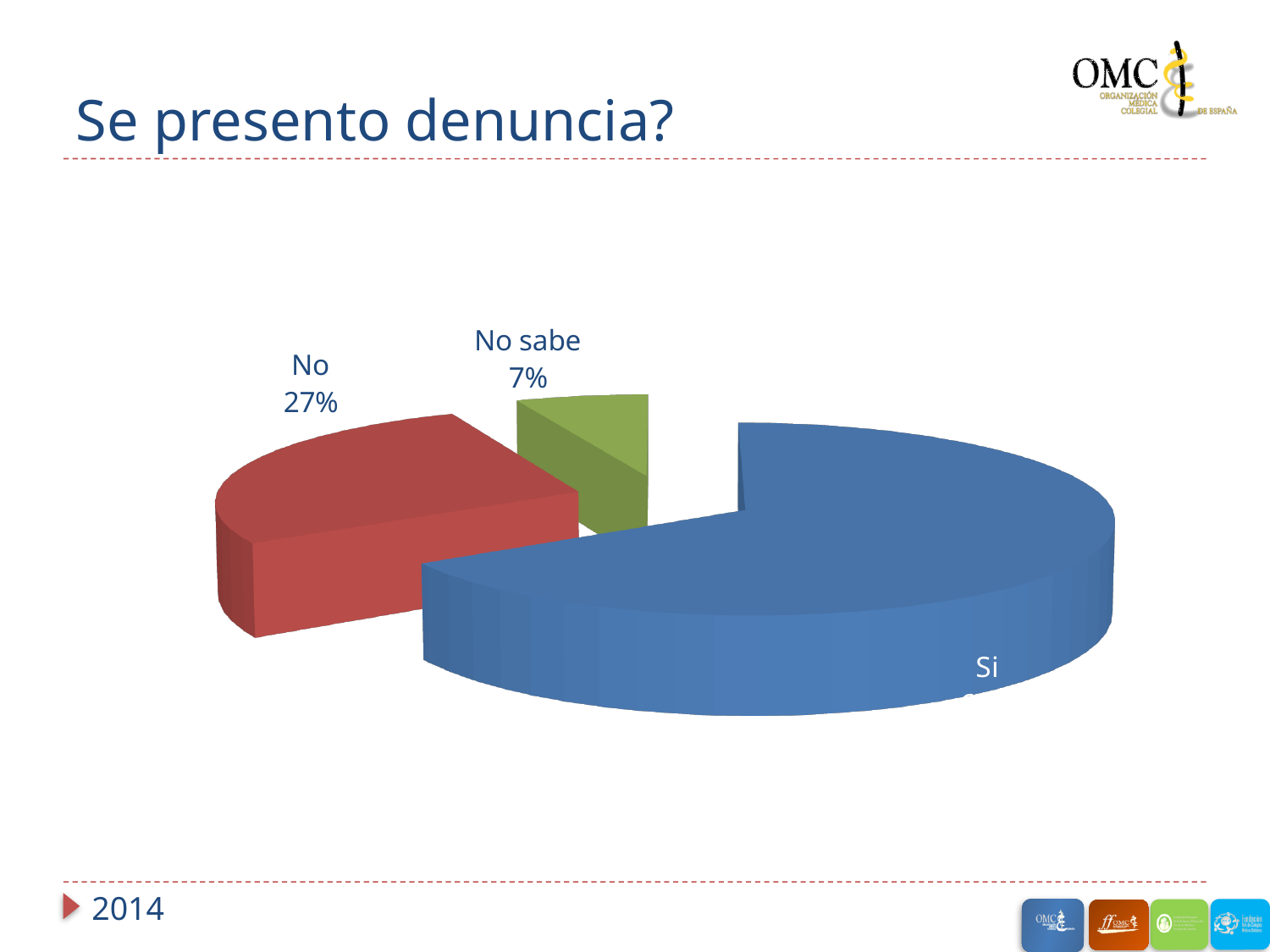
Which is larger, the "Si" slice or the "No" slice? Si What is the difference in percentage points between the "No" slice and the "No sabe" slice? 20 percentage points What share of the pie does the "No" slice represent? 27% Which is larger, the "No" slice or the "No sabe" slice? No Which slice of the pie chart is the largest? Si What is the title of the chart on the slide? Se presento denuncia? What percentage is shown for the "No sabe" slice? 7% What kind of chart is shown on the slide? pie chart How many slices does the pie chart have? 3 What colour is the "Si" slice of the pie chart? blue What percentage is shown for the "No" slice? 27% Which slice of the pie chart is the smallest? No sabe